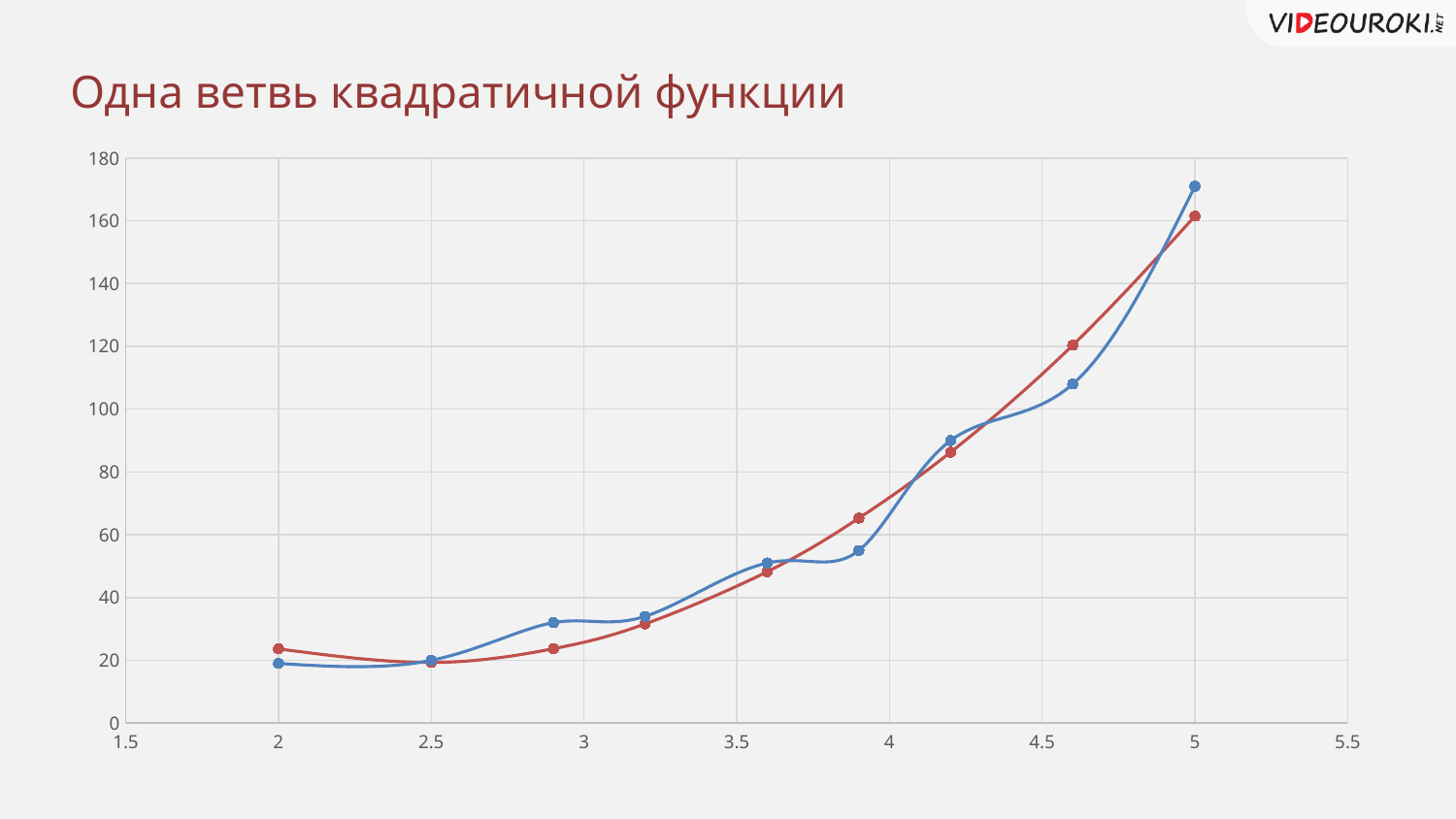
What kind of chart is shown on the slide? line chart At which x value does the blue series reach its highest point? 5 Is the value of the red series at x = 4.6 greater or less than 100? greater Is the value of the blue series at x = 4.6 greater or less than 120? less At x = 5, which series has the higher value, blue or red? blue Is the value of the blue series at x = 3.9 greater or less than 60? less How many data series are plotted on the chart? 2 Do the values of the red series rise or fall as x increases from 2.5 to 5? rise At x = 4.6, which series has the higher value, blue or red? red How many data points does the blue series have? 9 What is the title of the chart? Одна ветвь квадратичной функции